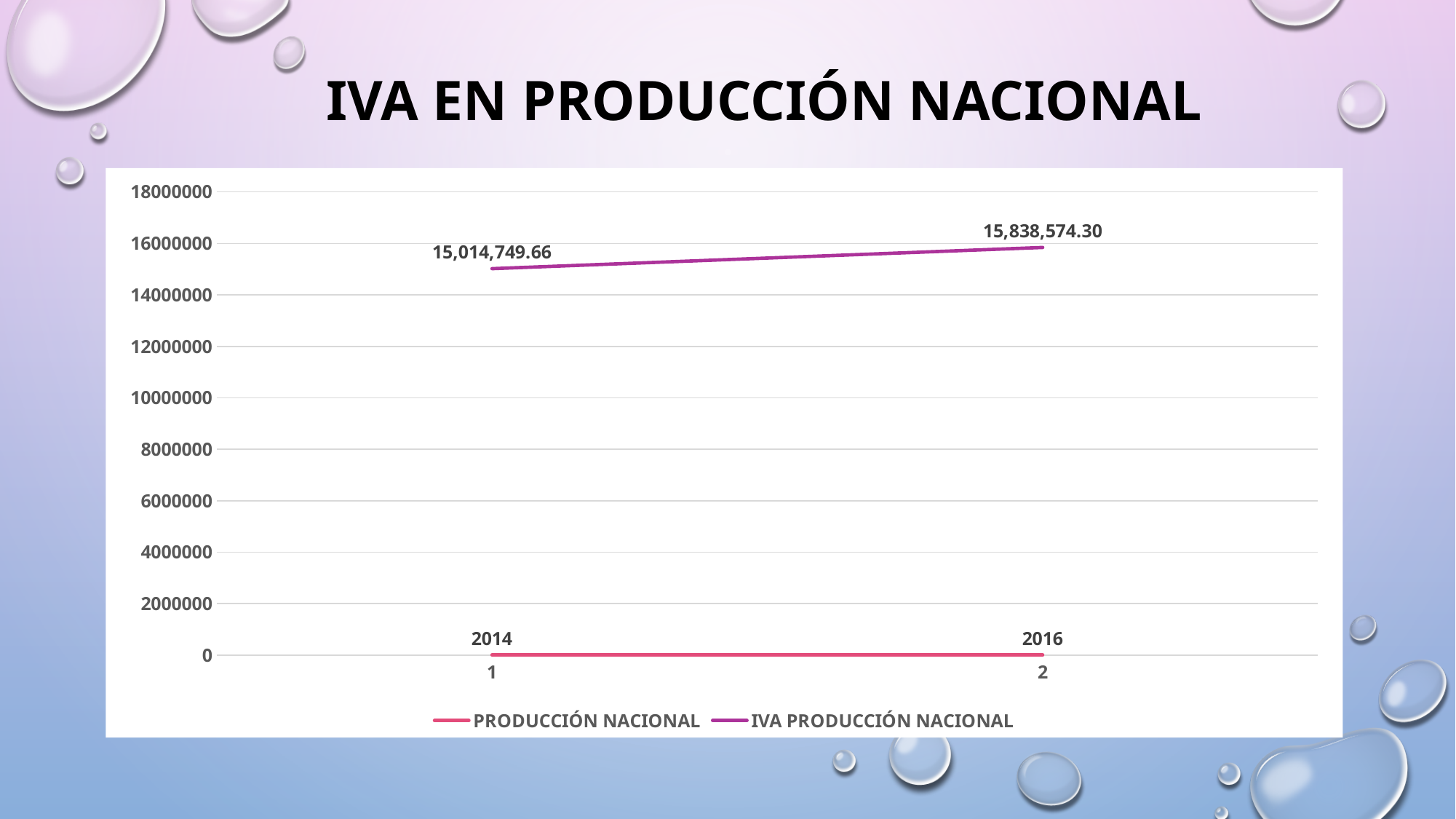
How many points are plotted along the x axis? 2 Which point has the higher IVA PRODUCCIÓN NACIONAL value, point 1 or point 2? point 2 What is the value of IVA PRODUCCIÓN NACIONAL at point 1? 15,014,749.66 Does the IVA PRODUCCIÓN NACIONAL line rise or fall from point 1 to point 2? rise What data label is shown for PRODUCCIÓN NACIONAL at point 2? 2016 What kind of chart is shown on the slide? line chart What data label is shown for PRODUCCIÓN NACIONAL at point 1? 2014 What is the title of the slide? IVA EN PRODUCCIÓN NACIONAL What is the difference between the IVA PRODUCCIÓN NACIONAL values at point 2 and point 1? 823,824.64 What is the value of IVA PRODUCCIÓN NACIONAL at point 2? 15,838,574.30 How many series does the legend list? 2 Is the value for IVA PRODUCCIÓN NACIONAL at point 1 greater or less than 16000000? less